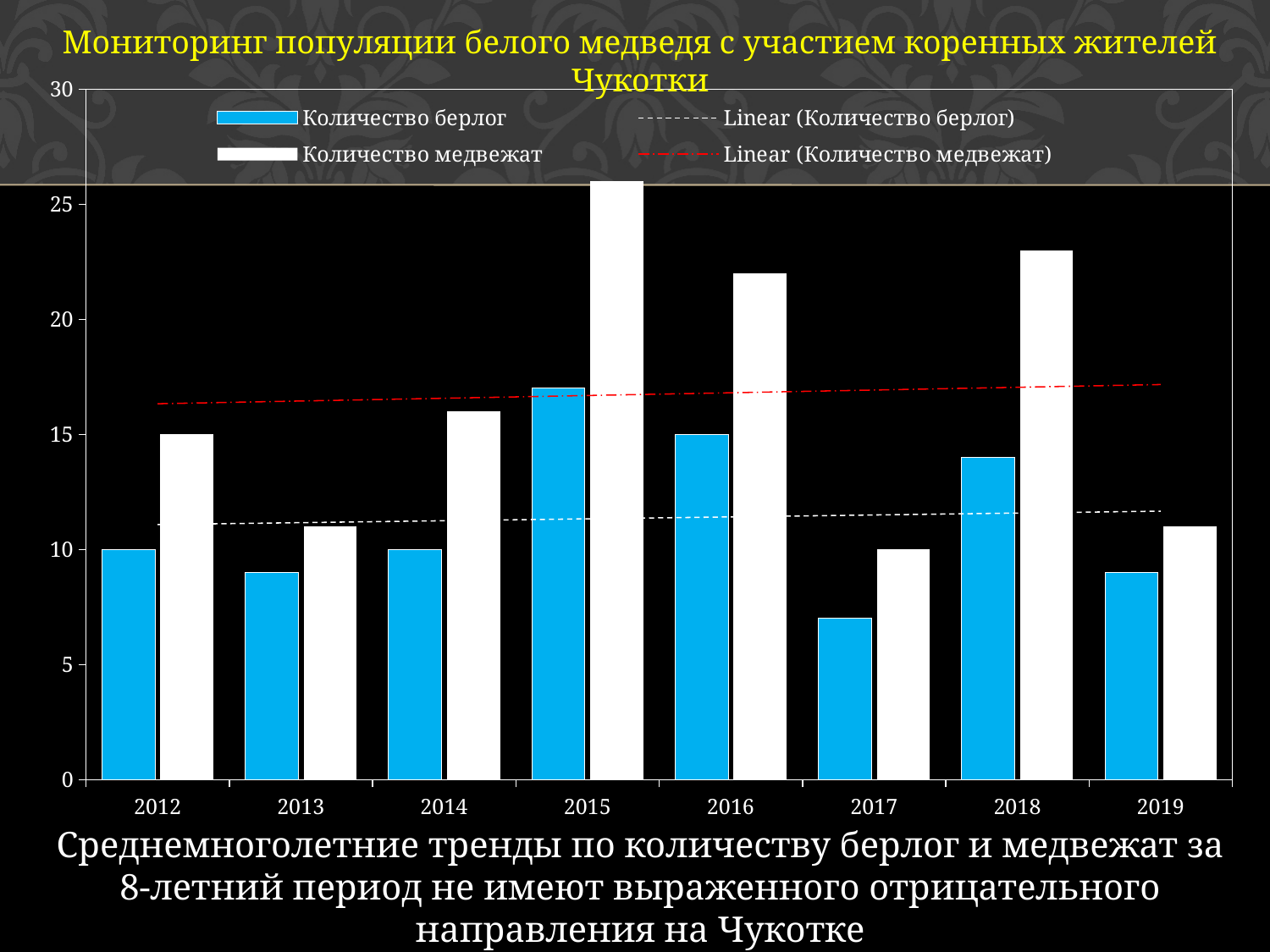
Which colour represents Количество берлог in the chart? blue What is the value of Количество медвежат for 2012? 15 How many entries does the chart's legend list? 4 Which is larger: Количество медвежат in 2015 or in 2012? 2015 What is the value of Количество берлог for 2012? 10 What kind of chart is shown on the slide? bar chart Is the value of Количество медвежат for 2015 greater or less than 25? greater In which year is Количество берлог lowest? 2017 How many years are shown along the x axis of the chart? 8 What is the value of Количество медвежат for 2017? 10 In which year is Количество медвежат highest? 2015 What is the value of Количество берлог for 2016? 15